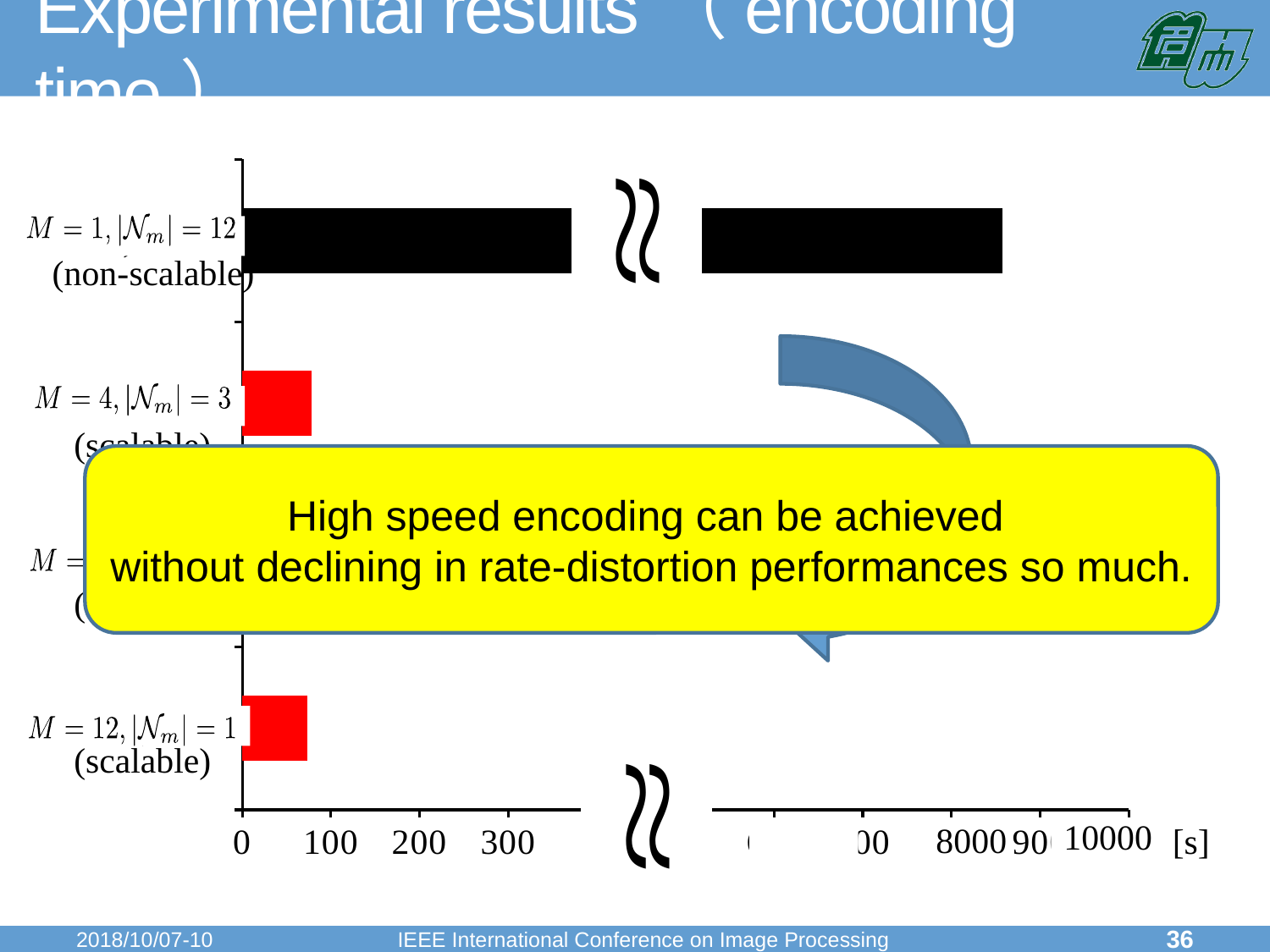
Is the encoding time for M = 12, |N_m| = 1 (scalable) greater or less than 100? less Is the encoding time for M = 1, |N_m| = 12 (non-scalable) greater or less than 300? greater Which has the larger encoding time: M = 1, |N_m| = 12 (non-scalable) or M = 12, |N_m| = 1 (scalable)? M = 1, |N_m| = 12 (non-scalable) What kind of chart is shown on the slide? bar chart Is the encoding time for M = 4, |N_m| = 3 (scalable) greater or less than 100? less How many categories (bars) are plotted in the chart? 4 Which category has the longest bar (highest encoding time)? M = 1, |N_m| = 12 (non-scalable) What colour is the bar for the non-scalable configuration M = 1, |N_m| = 12? black What unit is shown at the end of the horizontal axis? [s]